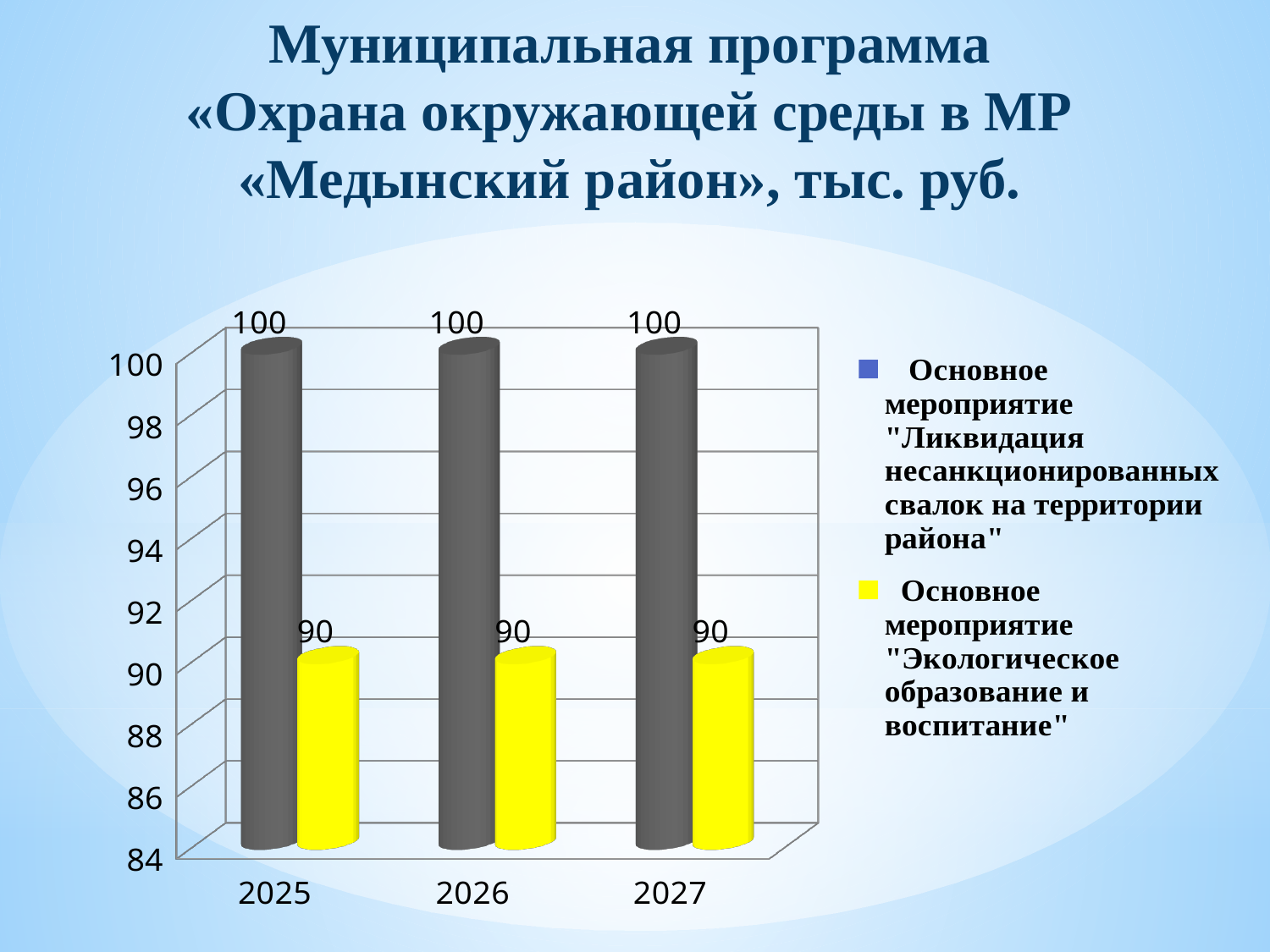
What unit is stated in the slide title? тыс. руб. Which series has the larger value in 2027? Ликвидация несанкционированных свалок на территории района Do the values for "Ликвидация несанкционированных свалок" rise, fall or stay the same from 2025 to 2027? Stay the same What is the difference between the two series' values in 2026? 10 What is the value for "Ликвидация несанкционированных свалок на территории района" in 2025? 100 How many series does the legend list? 2 What kind of chart is shown on the slide? Bar chart What colour are the bars for "Экологическое образование и воспитание"? Yellow How many years are shown on the x axis? 3 Is the value for "Экологическое образование и воспитание" in 2025 greater or less than 94? less What is the value for "Экологическое образование и воспитание" in 2026? 90 What is the value for "Экологическое образование и воспитание" in 2027? 90